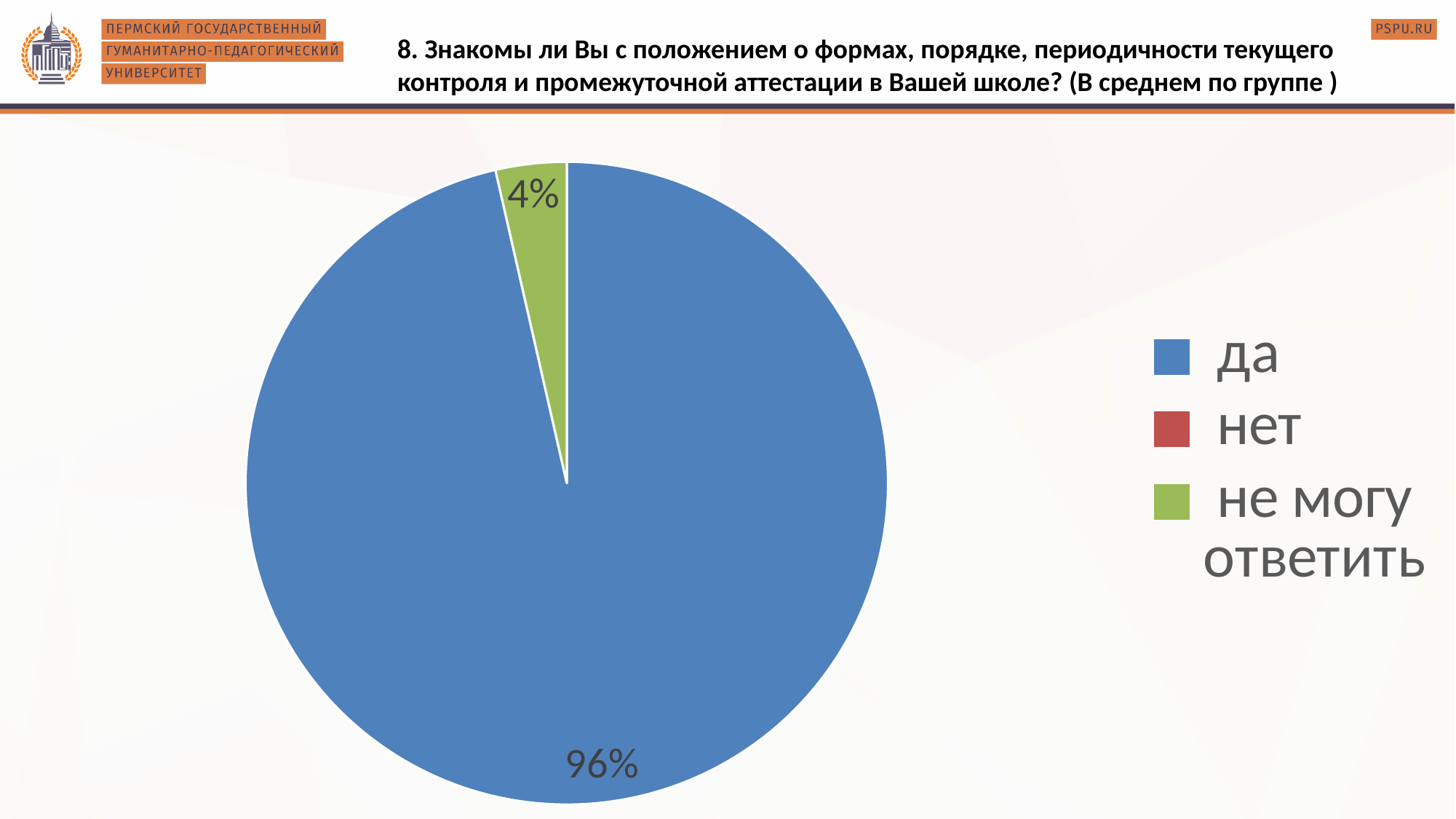
Which of the visible slices is the smallest? не могу ответить How many slices with data labels are visible in the pie? 2 What is the difference in percentage points between the "да" slice and the "не могу ответить" slice? 92 What colour is the "не могу ответить" slice? green What share of the pie does "да" represent? 96% Which is larger, the "да" slice or the "не могу ответить" slice? да What colour is the "да" slice? blue Which category has the largest slice of the pie? да How many entries does the legend list? 3 What kind of chart is shown on the slide? pie chart What share of the pie does "не могу ответить" represent? 4%